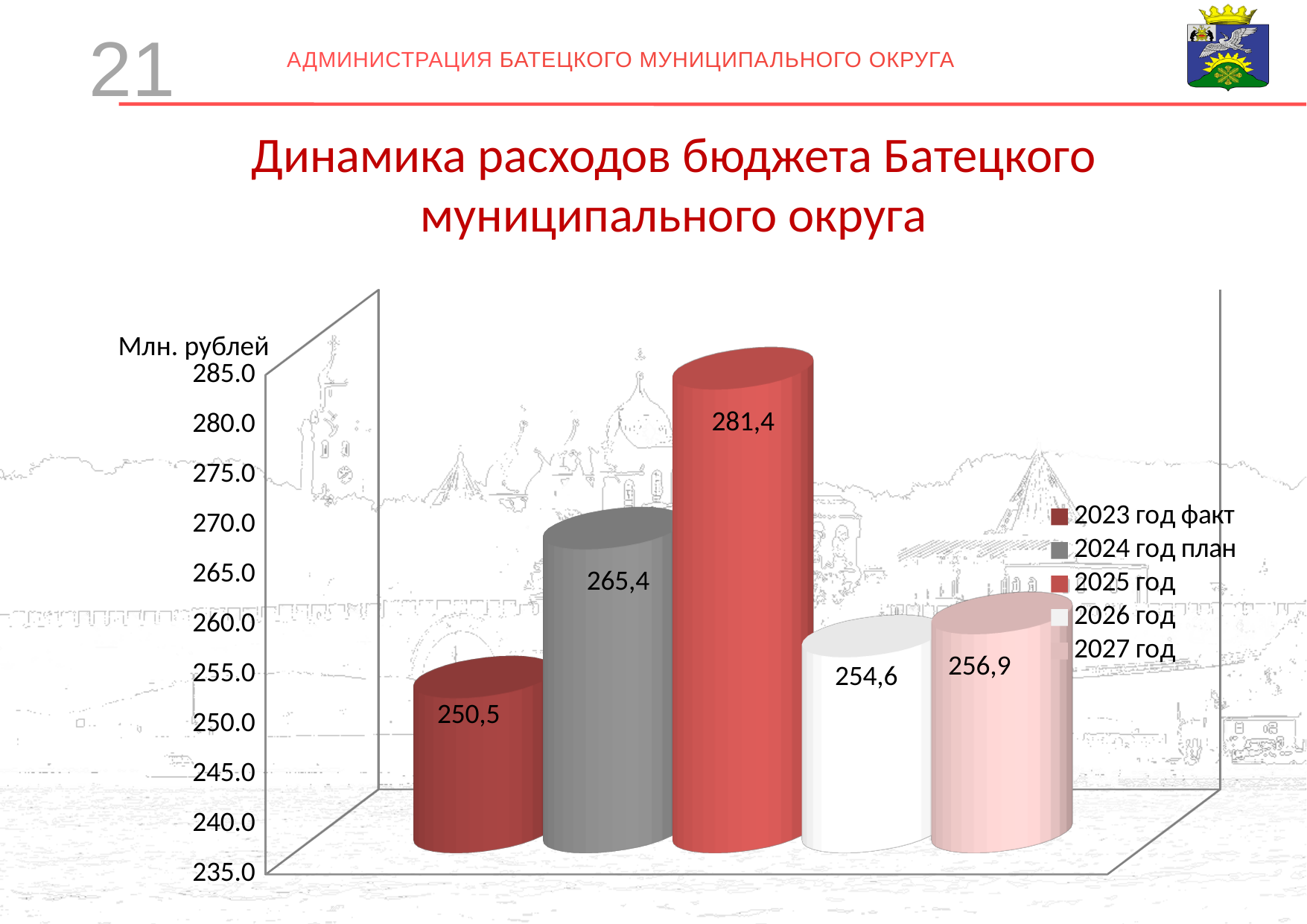
What is the value for 2027 год? 256,9 What is the value for 2023 год факт? 250,5 What is the value for 2025 год? 281,4 What is the difference between the values for 2025 год and 2024 год план? 16,0 What kind of chart is shown on the slide? bar chart What unit is shown on the vertical axis of the chart? Млн. рублей Is the value for 2026 год greater or less than 260.0? less How many series does the legend list? 5 What is the difference between the values for 2027 год and 2026 год? 2,3 Which is larger, the value for 2024 год план or the value for 2026 год? 2024 год план Which year has the lowest budget expenditure? 2023 год факт Which year has the highest budget expenditure? 2025 год